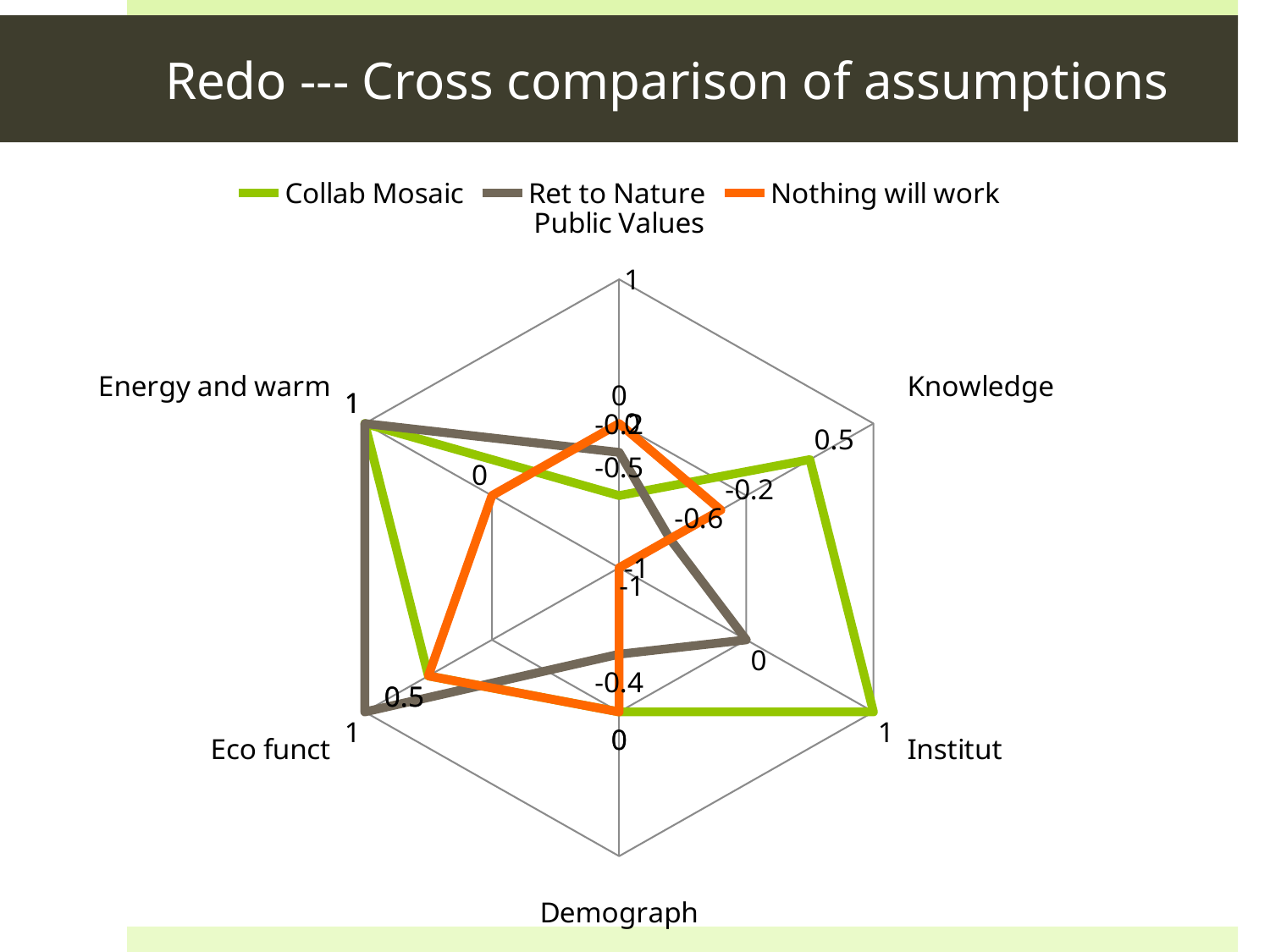
Which series has the larger value for Institut, Collab Mosaic or Nothing will work? Collab Mosaic How many series does the legend list? 3 For which category does Nothing will work have its lowest value? Institut What is the difference between the Collab Mosaic and Nothing will work values for Institut? 2 What is the value of Collab Mosaic for Institut? 1 What is the value of Ret to Nature for Knowledge? -0.6 What is the value of Ret to Nature for Demograph? -0.4 What is the value of Collab Mosaic for Knowledge? 0.5 What is the value of Nothing will work for Institut? -1 How many categories (axes) does the radar chart have? 6 What kind of chart is shown on the slide? Radar chart What is the value of Ret to Nature for Eco funct? 1